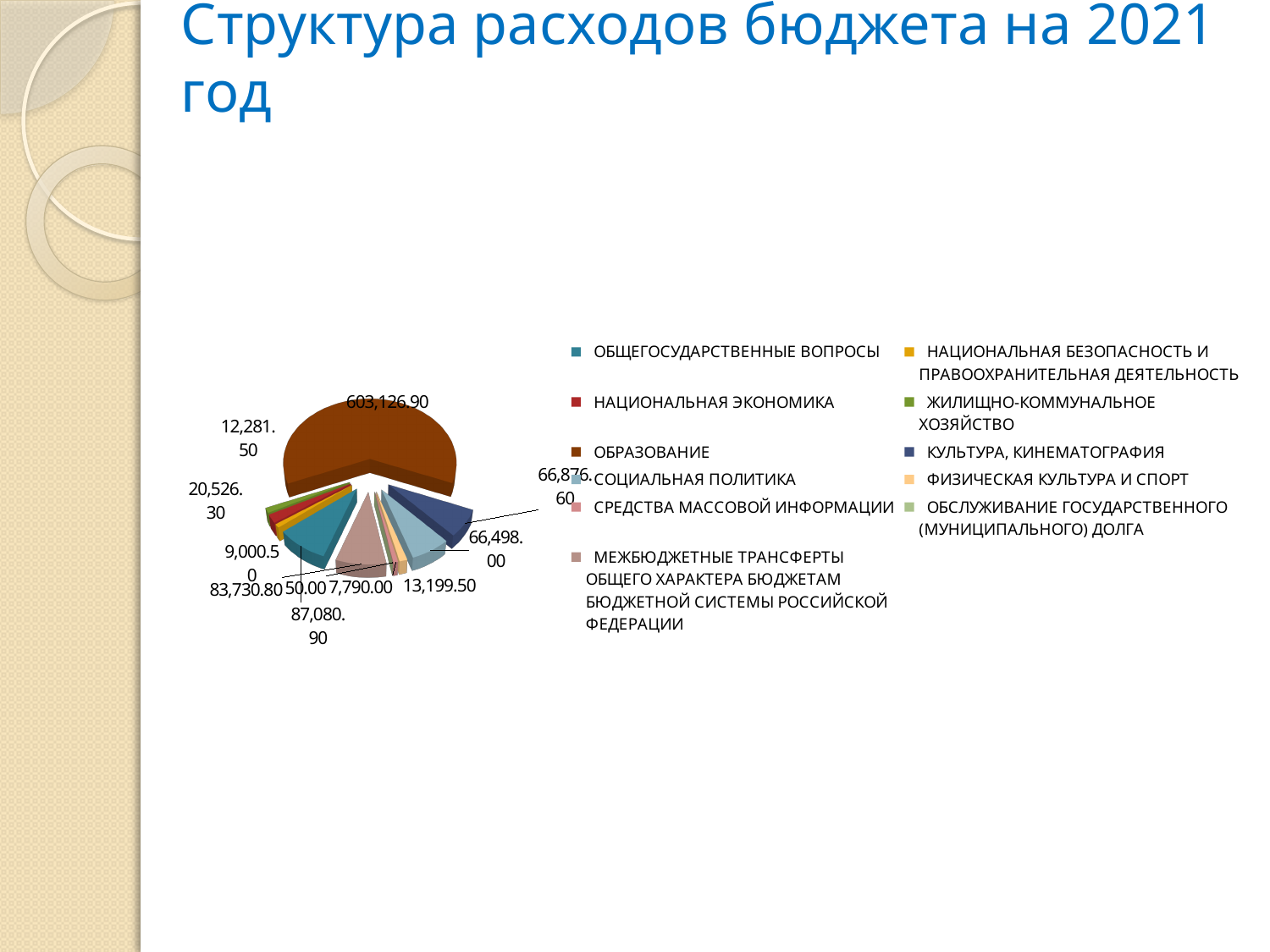
What colour is the ОБРАЗОВАНИЕ slice? brown Which is larger: the slice labelled 603,126.90 or the slice labelled 87,080.90? 603,126.90 Which category has the largest slice of the pie? ОБРАЗОВАНИЕ What is the value shown for ОБЩЕГОСУДАРСТВЕННЫЕ ВОПРОСЫ? 87,080.90 What is the difference between the slices labelled 87,080.90 and 83,730.80? 3,350.10 What is the value shown for ОБРАЗОВАНИЕ? 603,126.90 How many categories does the legend list? 11 What is the smallest data label value shown on the pie chart? 50.00 What is the title of the slide? Структура расходов бюджета на 2021 год What is the value shown for КУЛЬТУРА, КИНЕМАТОГРАФИЯ? 66,876.60 What kind of chart is shown on the slide? pie chart